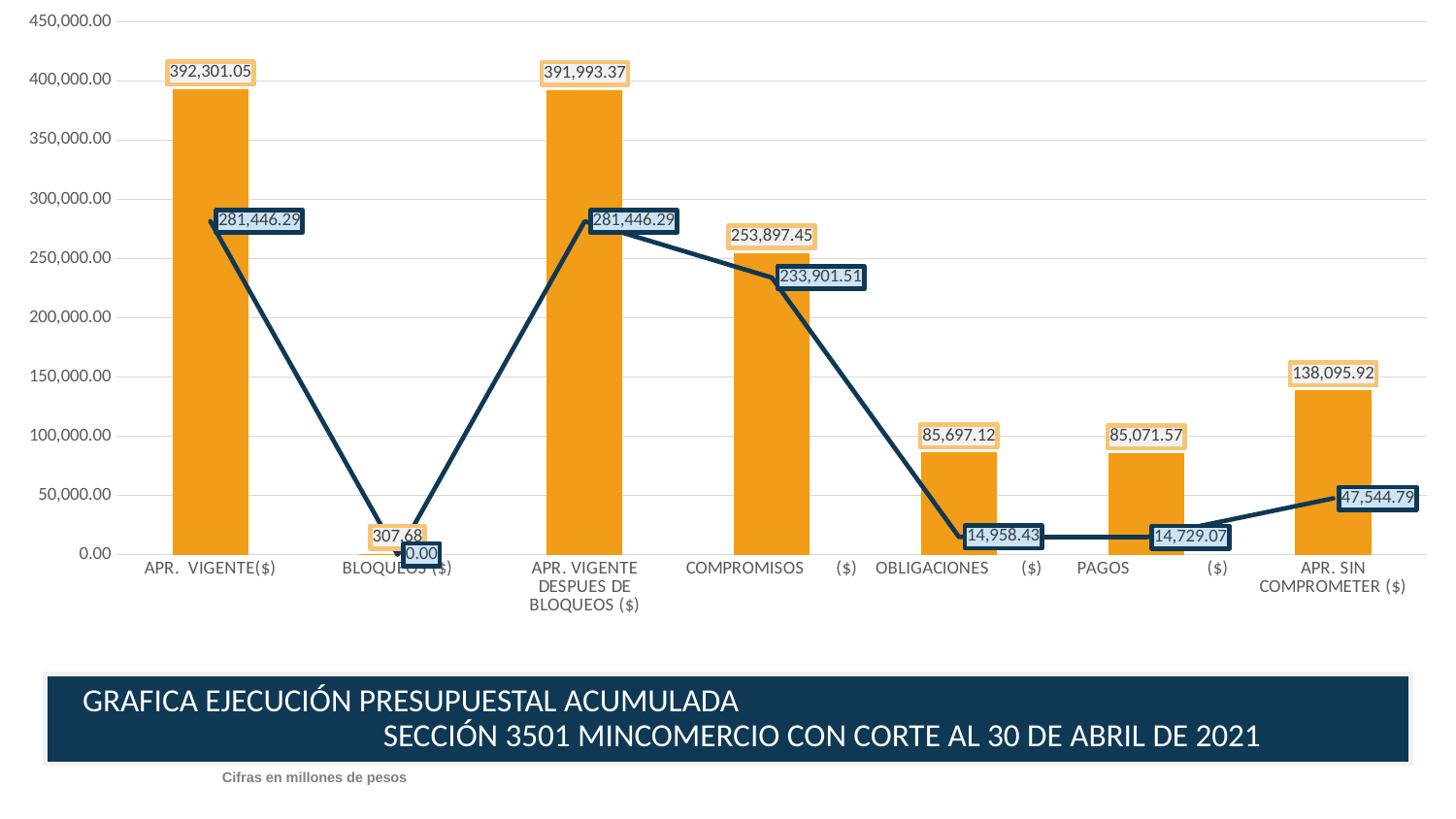
Is the bar value for APR. SIN COMPROMETER ($) greater or less than 150,000.00? less What is the line value shown for OBLIGACIONES ($)? 14,958.43 According to the note below the chart, in what units are the figures expressed? Millones de pesos What is the bar value for COMPROMISOS ($)? 253,897.45 How many categories are shown on the x axis? 7 Which has the larger bar value, OBLIGACIONES ($) or PAGOS ($)? OBLIGACIONES ($) What kind of chart is shown on the slide? bar and line chart What is the difference between the bar values for APR. VIGENTE($) and APR. VIGENTE DESPUES DE BLOQUEOS ($)? 307.68 Which category has the lowest bar value? BLOQUEOS ($) For COMPROMISOS ($), what is the difference between the bar value and the line value? 19,995.94 Which category has the tallest bar? APR. VIGENTE($) What is the line value shown for APR. SIN COMPROMETER ($)? 47,544.79